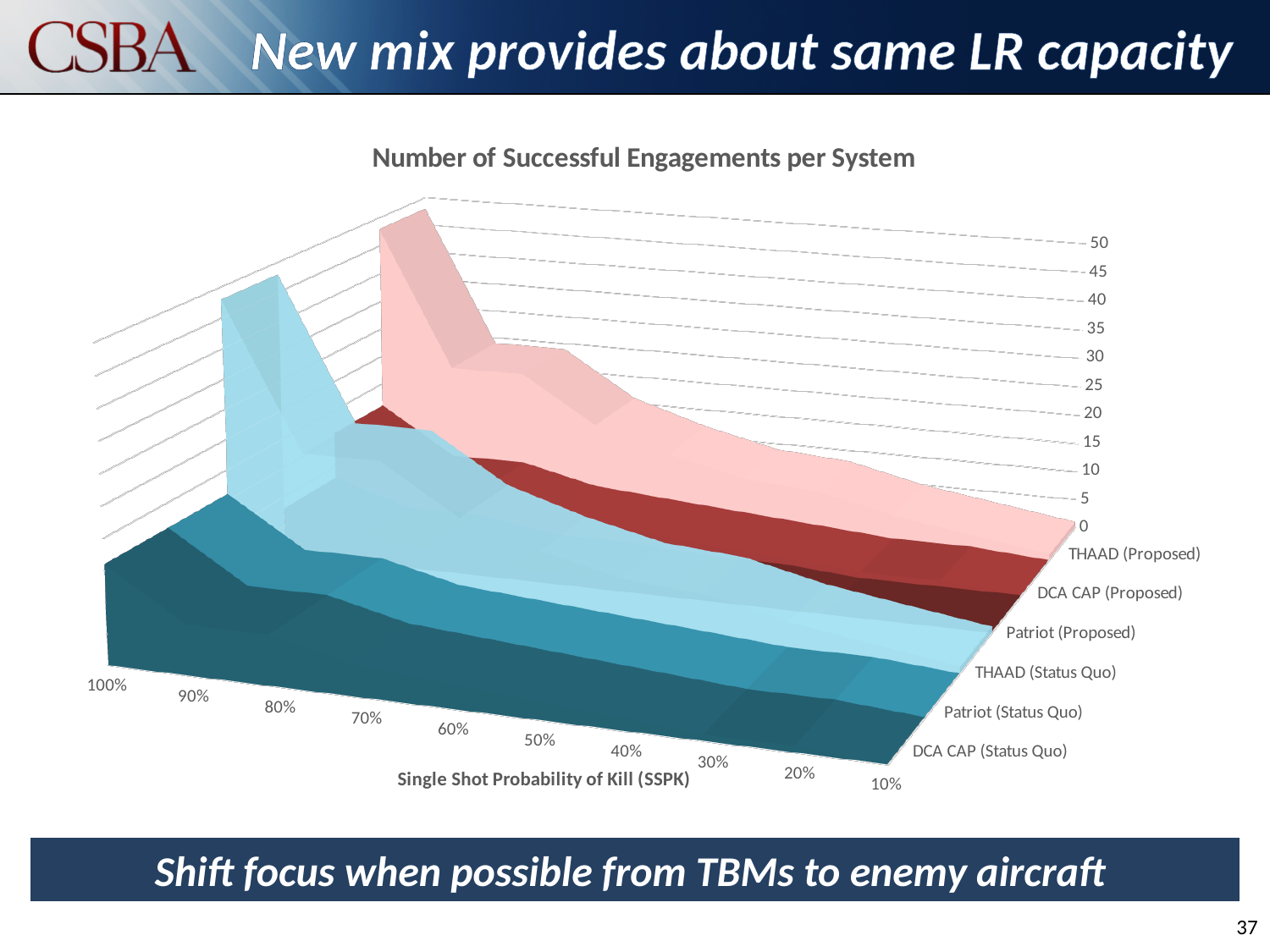
What kind of chart is shown on the slide? 3D area (surface) chart Which series is plotted at the front of the chart? DCA CAP (Status Quo) What is the highest SSPK value shown on the x axis? 100% How many SSPK categories are shown along the x axis? 10 Do the number of successful engagements rise or fall as SSPK decreases from 100% to 10%? fall What is the label of the x axis? Single Shot Probability of Kill (SSPK) What is the title of the chart? Number of Successful Engagements per System How many systems (series) are plotted in the chart? 6 What is the interval between tick marks on the vertical axis? 5 Which series is plotted at the back of the chart? THAAD (Proposed) What is the lowest SSPK value shown on the x axis? 10% What is the highest value shown on the vertical axis? 50